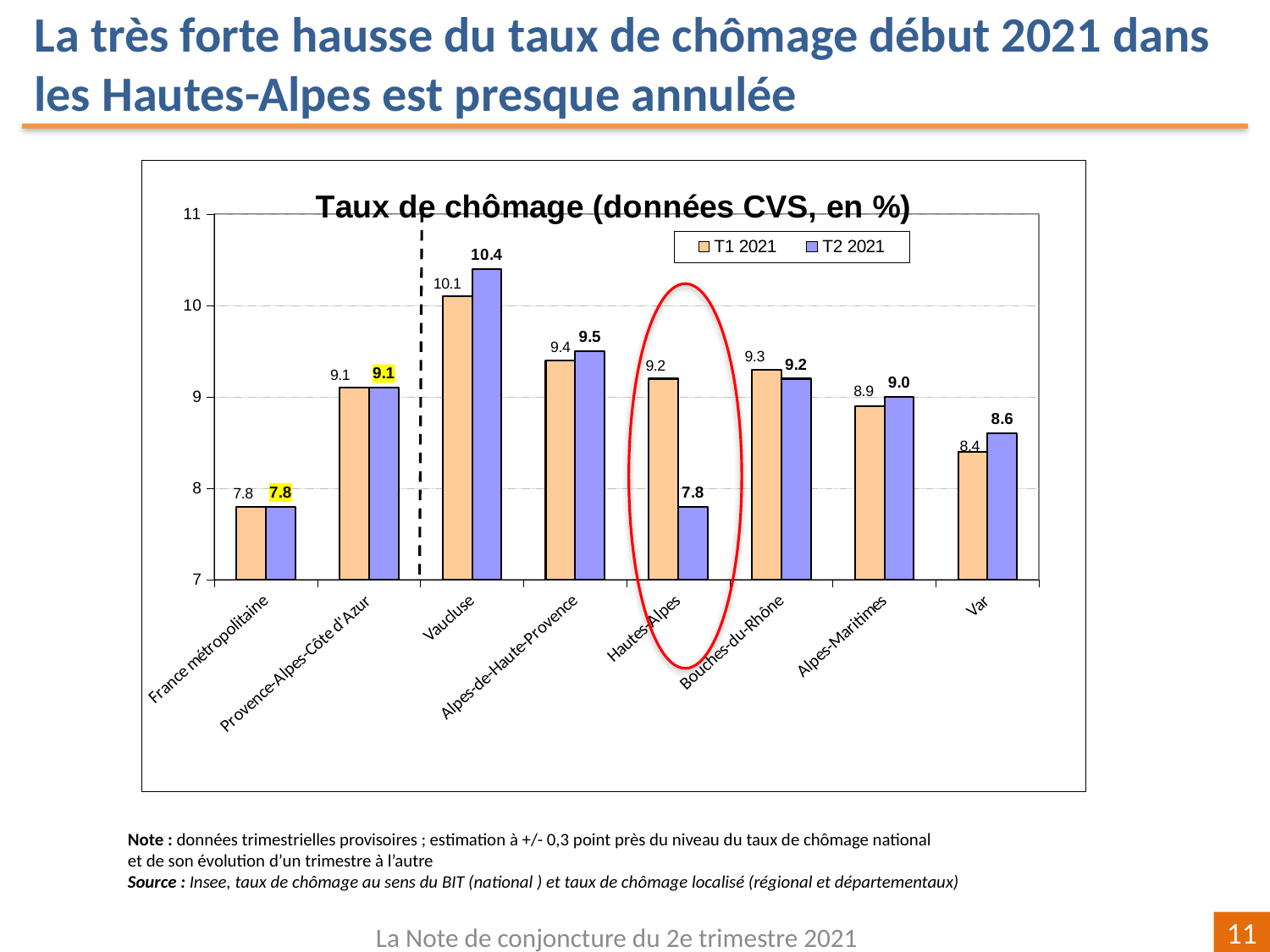
How many series does the legend list? 2 Which category has the highest T2 2021 value? Vaucluse What is the T2 2021 value for Vaucluse? 10.4 What is the T2 2021 value for Var? 8.6 What is the difference between the T1 2021 and T2 2021 values for Hautes-Alpes? 1.4 What is the title of the chart? Taux de chômage (données CVS, en %) How many categories are shown on the x axis? 8 What type of chart is shown on the slide? bar chart Is the T1 2021 value for Vaucluse greater or less than 10? greater Which category has the lowest T1 2021 value? France métropolitaine Which is larger for Bouches-du-Rhône, the T1 2021 value or the T2 2021 value? T1 2021 What is the T1 2021 value for Hautes-Alpes? 9.2